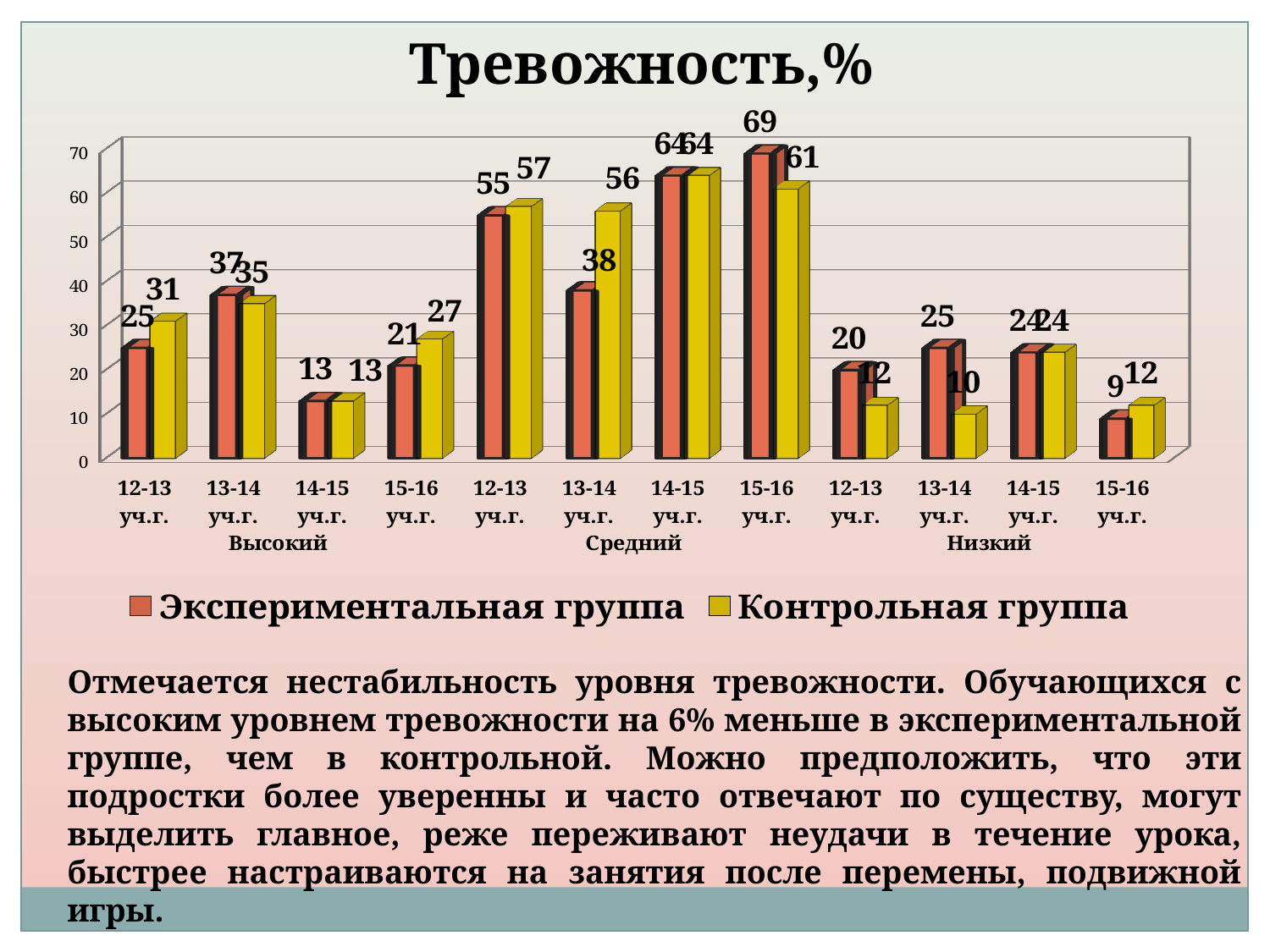
What is the value for Контрольная группа in 13-14 уч.г. in the Средний group? 56 What is the title of the chart? Тревожность,% What is the difference between Контрольная группа and Экспериментальная группа in 13-14 уч.г. in the Средний group? 18 What is the value for Экспериментальная группа in 15-16 уч.г. in the Средний group? 69 What is the value for Контрольная группа in 12-13 уч.г. in the Высокий group? 31 How many series does the legend list? 2 How many categories are shown on the x axis? 12 Which category has the highest value for Экспериментальная группа? 15-16 уч.г. (Средний) What type of chart is shown on the slide? bar chart Which category has the lowest value for Экспериментальная группа? 15-16 уч.г. (Низкий) In 13-14 уч.г. in the Низкий group, which series has the larger value? Экспериментальная группа What is the difference between Экспериментальная группа and Контрольная группа in 15-16 уч.г. in the Средний group? 8